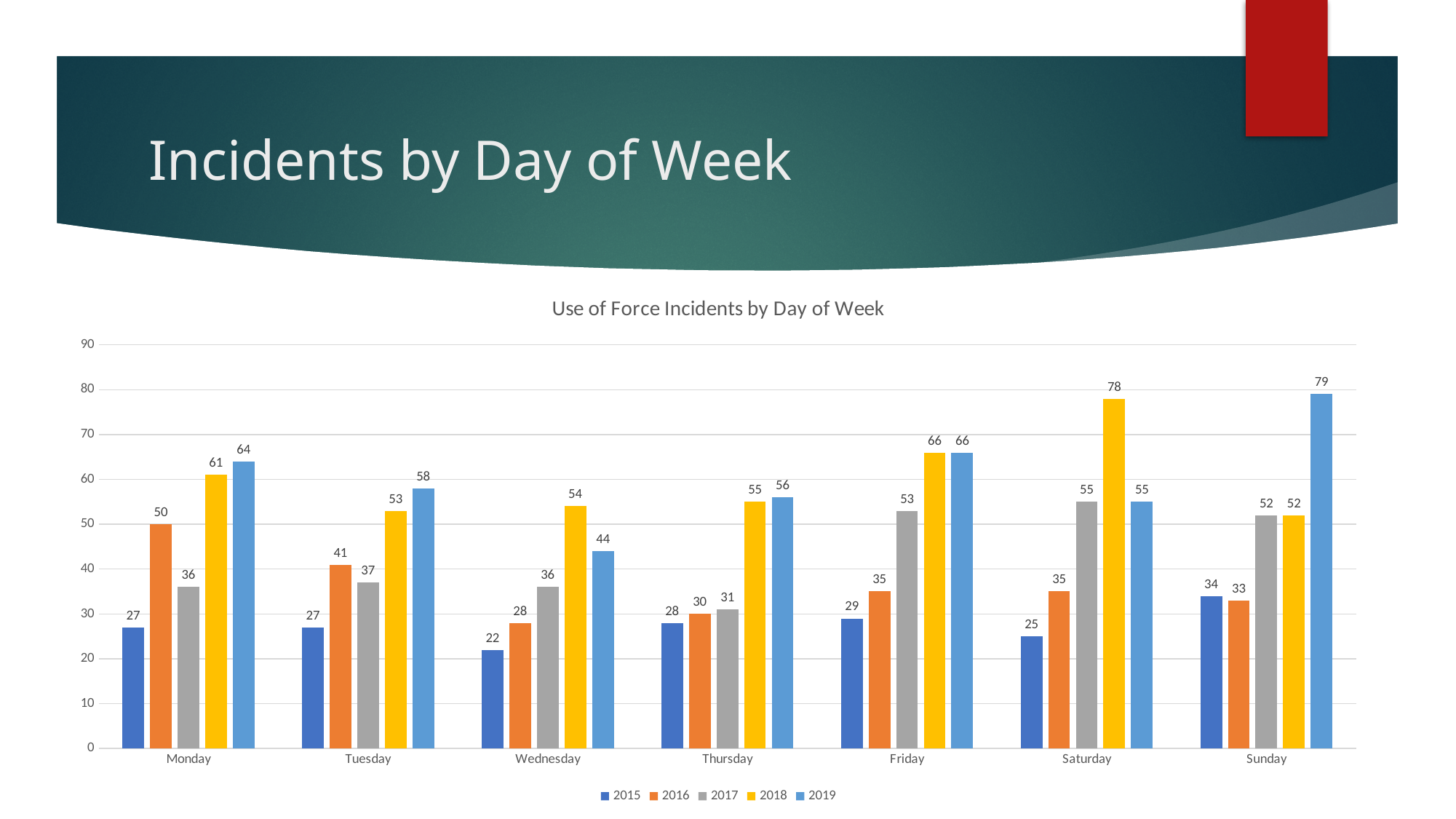
Which day has the highest value for 2019? Sunday What is the value for 2016 on Monday? 50 What is the title of the chart? Use of Force Incidents by Day of Week How many days of the week are shown on the x axis? 7 Which day has the lowest value for 2015? Wednesday Which is larger on Wednesday, the 2018 value or the 2019 value? 2018 What kind of chart is shown? Bar chart Which colour represents 2018 in the legend? Yellow What is the value for 2019 on Sunday? 79 What is the value for 2018 on Saturday? 78 What is the difference between the 2019 and 2015 values on Sunday? 45 How many series does the legend list? 5